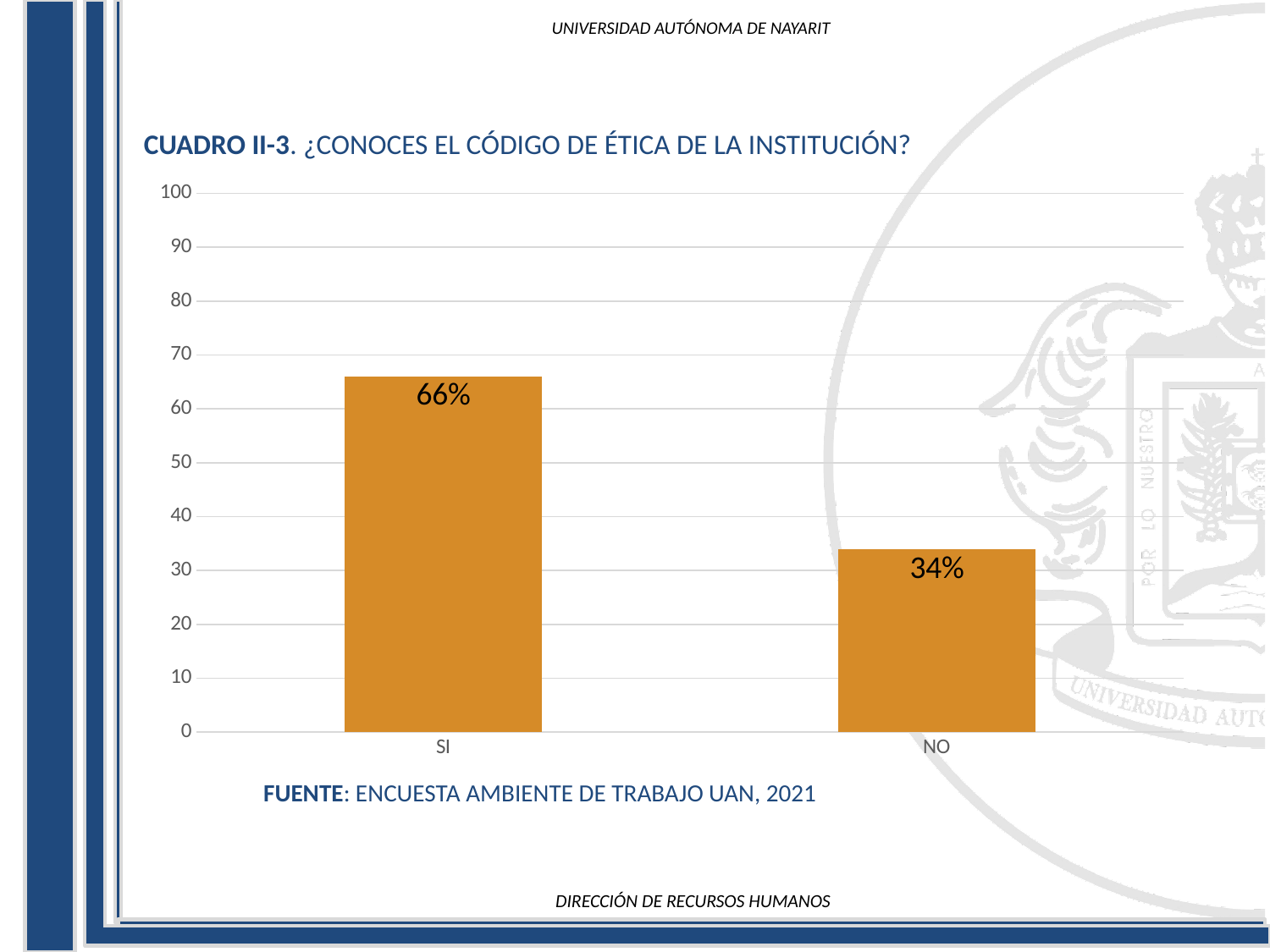
Which category has the lowest value? NO What kind of chart is shown on the slide? bar chart What is the difference between the values for SI and NO? 32% Which category has the highest value? SI What is the title of the chart? CUADRO II-3. ¿CONOCES EL CÓDIGO DE ÉTICA DE LA INSTITUCIÓN? Is the value for SI greater or less than 60? greater How many categories are shown on the x axis? 2 What is the value for SI? 66% Is the value for NO greater or less than 40? less Which is larger, the value for SI or the value for NO? SI What is the value for NO? 34% What source is cited below the chart? ENCUESTA AMBIENTE DE TRABAJO UAN, 2021